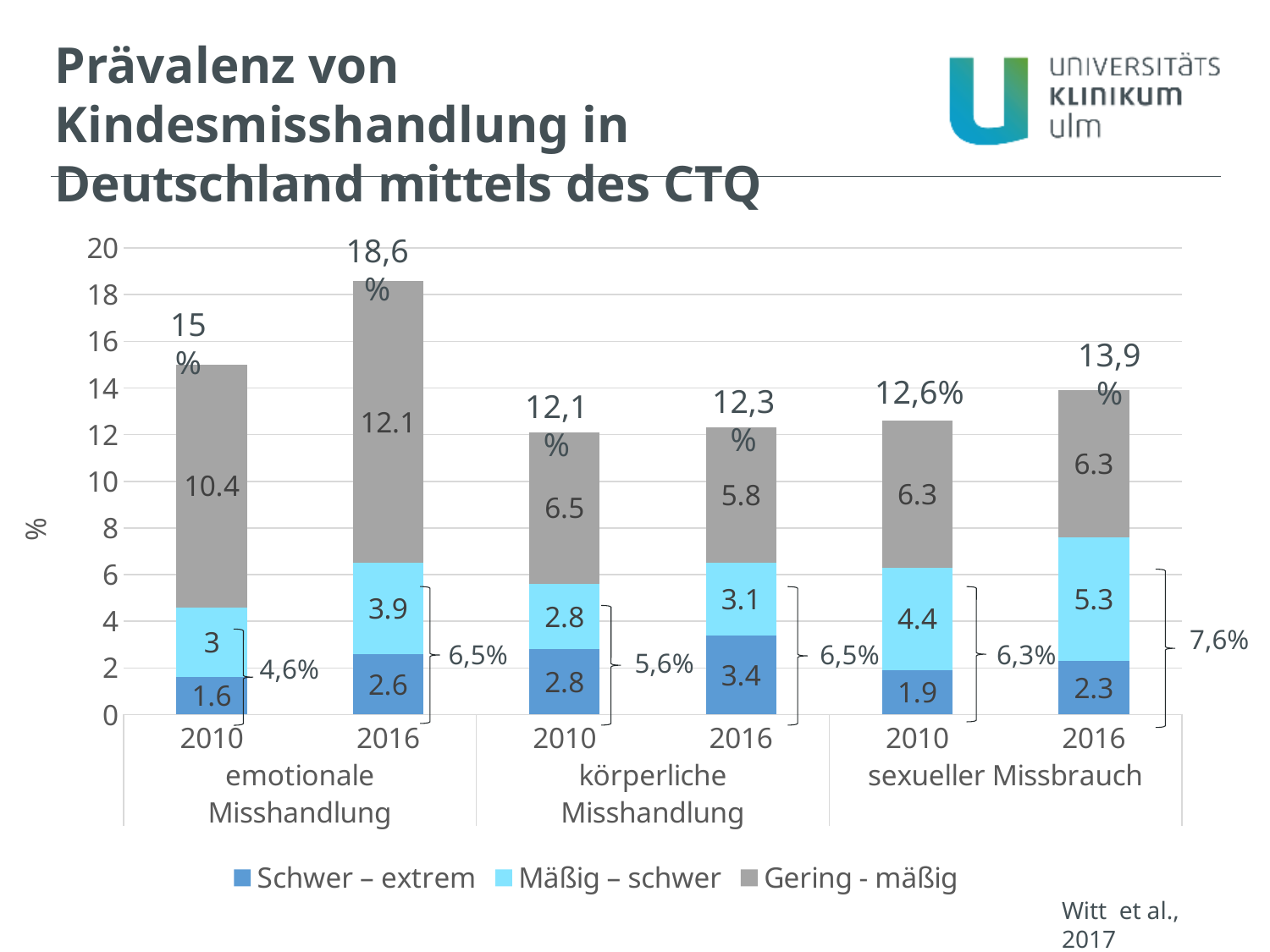
What is the value of the 'Mäßig – schwer' segment for sexueller Missbrauch in 2010? 4.4 Which is larger: the 'Schwer – extrem' segment for körperliche Misshandlung in 2016 or for sexueller Missbrauch in 2016? körperliche Misshandlung 2016 What is the value of the 'Schwer – extrem' segment for körperliche Misshandlung in 2016? 3.4 What type of chart is shown on the slide? stacked bar chart Which bar has the lowest total value? körperliche Misshandlung 2010 Which bar has the highest total value? emotionale Misshandlung 2016 How many bars are plotted in the chart? 6 What is the total printed above the bar for emotionale Misshandlung in 2016? 18,6% What is the value of the 'Gering - mäßig' segment for emotionale Misshandlung in 2016? 12.1 What is the difference between the 'Gering - mäßig' segments for emotionale Misshandlung in 2016 and 2010? 1.7 How many series does the legend list? 3 What is the total printed above the bar for sexueller Missbrauch in 2010? 12,6%